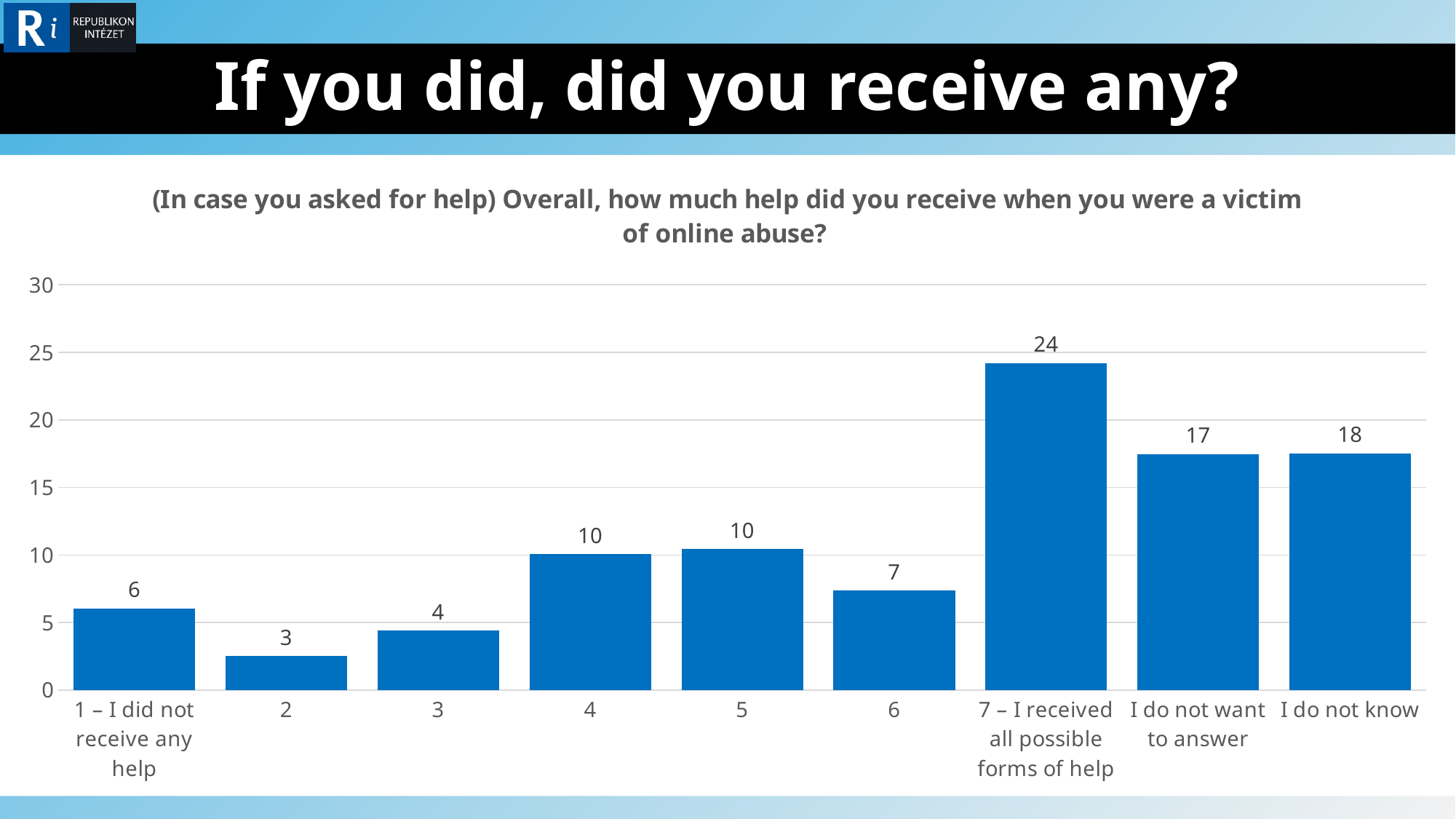
What kind of chart is shown on the slide? Bar chart What is the value for "7 – I received all possible forms of help"? 24 Is the value for "I do not want to answer" greater or less than 15? greater Which category has the highest value? 7 – I received all possible forms of help What is the value for "I do not know"? 18 What is the difference between the values for "7 – I received all possible forms of help" and "I do not want to answer"? 7 What is the value for "1 – I did not receive any help"? 6 What is the difference between the values for "I do not know" and "I do not want to answer"? 1 Which is larger, the value for "6" or the value for "3"? 6 Which category has the lowest value? 2 How many categories are shown on the x axis? 9 What is the title of the chart? (In case you asked for help) Overall, how much help did you receive when you were a victim of online abuse?